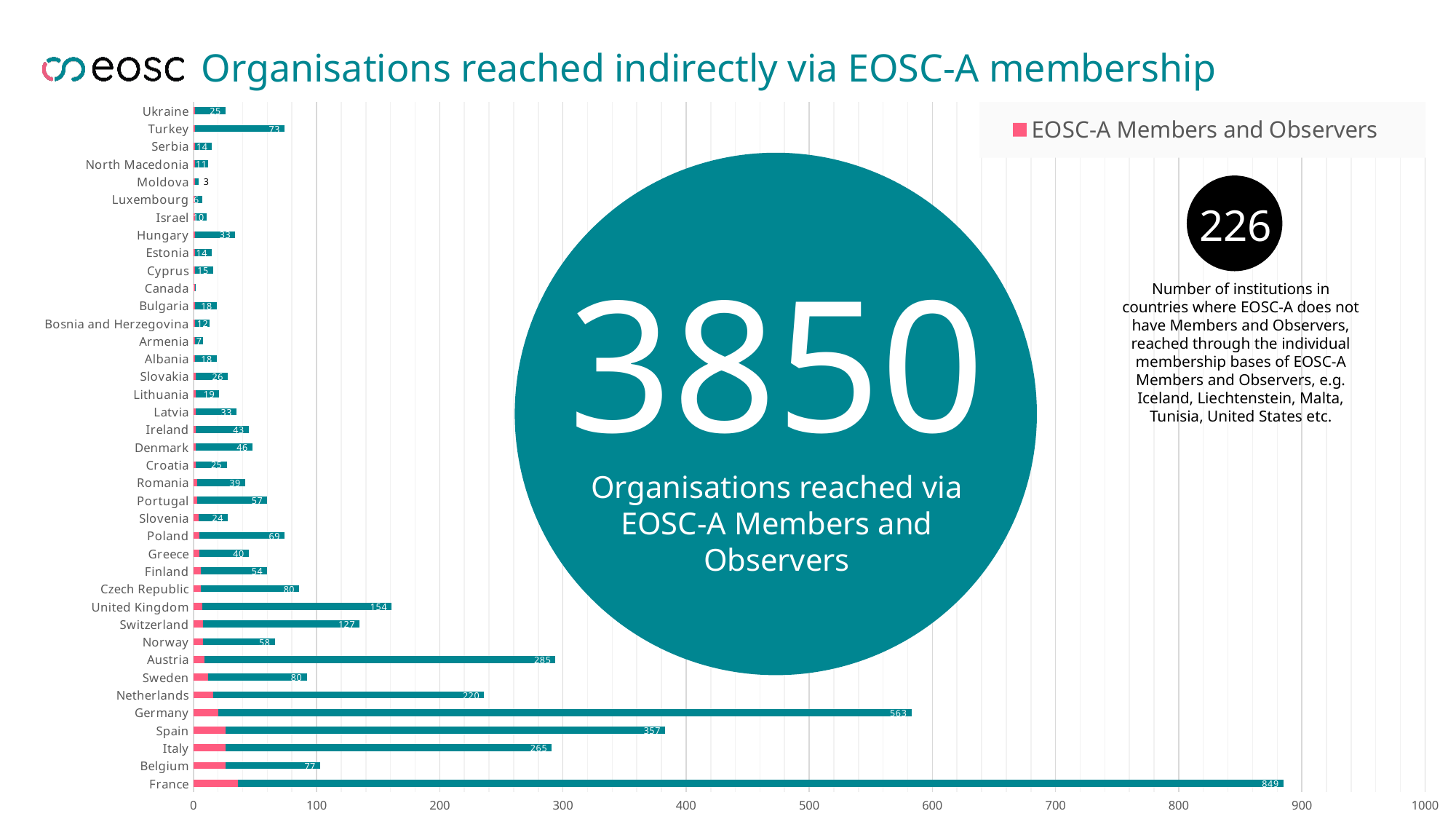
Which has the larger data label, Austria or Italy? Austria Which country has the longest bar in the chart? France What is the data label on the bar for the United Kingdom? 154 What is the data label on the bar for Germany? 563 What is the data label on the bar for Turkey? 73 Is the total bar length for France greater or less than 800? greater How many countries are listed on the vertical axis of the chart? 39 What large number is shown in the teal circle for organisations reached via EOSC-A Members and Observers? 3850 What is the data label on the bar for France? 849 What is the difference between the data labels for Germany and Spain? 206 What kind of chart is shown on the slide? bar chart What is the data label on the bar for Spain? 357